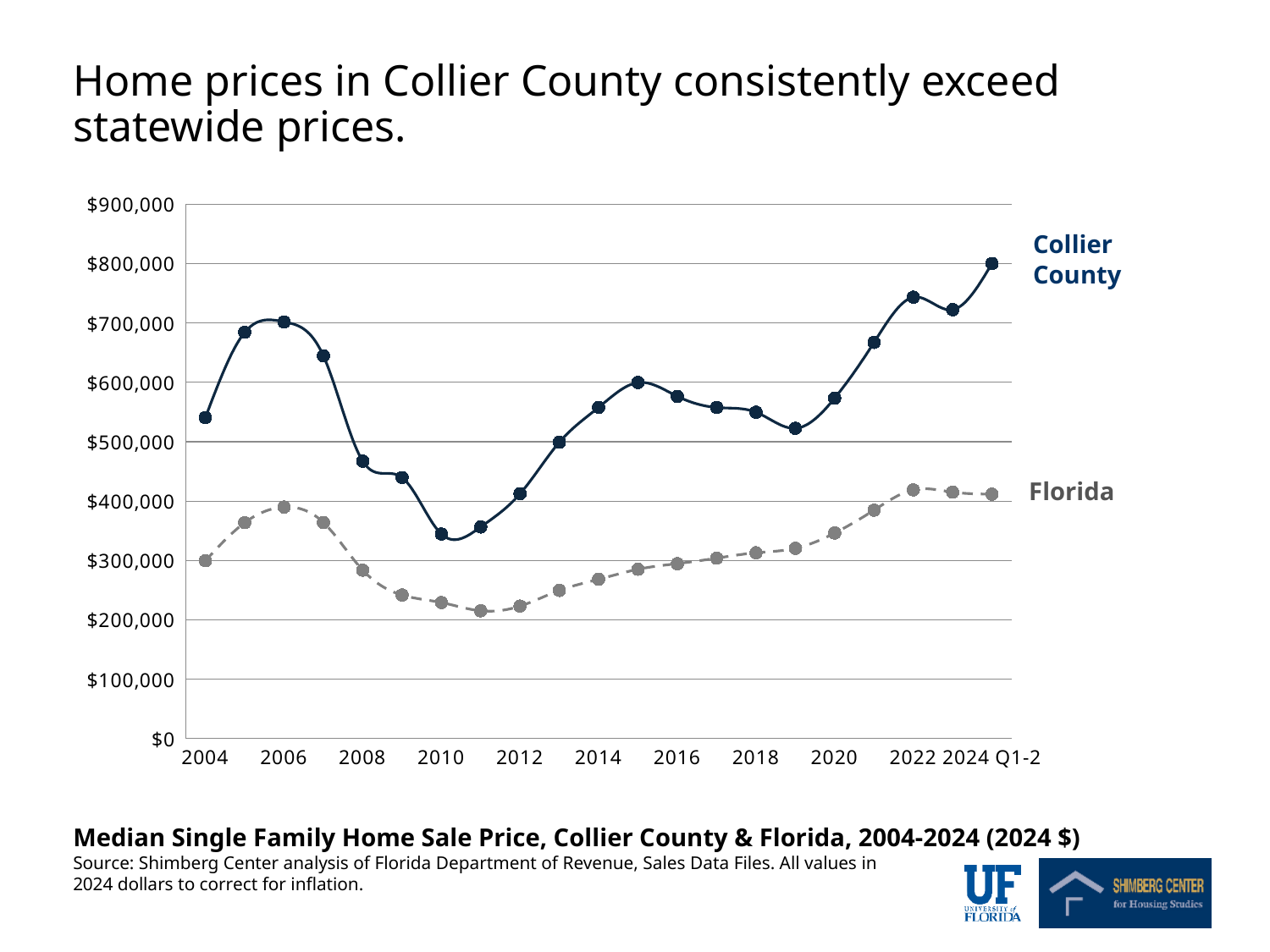
Do Collier County prices rise or fall from 2019 to 2022? rise Is the Collier County value for 2010 greater or less than $400,000? less Do Florida prices rise or fall from 2006 to 2011? fall Which two series are labelled on the chart? Collier County and Florida Is the Florida value for 2011 greater or less than $300,000? less Is the Florida value for 2022 greater or less than $400,000? greater How many series are plotted on the chart? 2 What kind of chart is shown on the slide? line chart In which year does the Collier County line reach its highest value? 2024 Q1-2 Which series has the higher value in 2004, Collier County or Florida? Collier County How many data points does each line have? 21